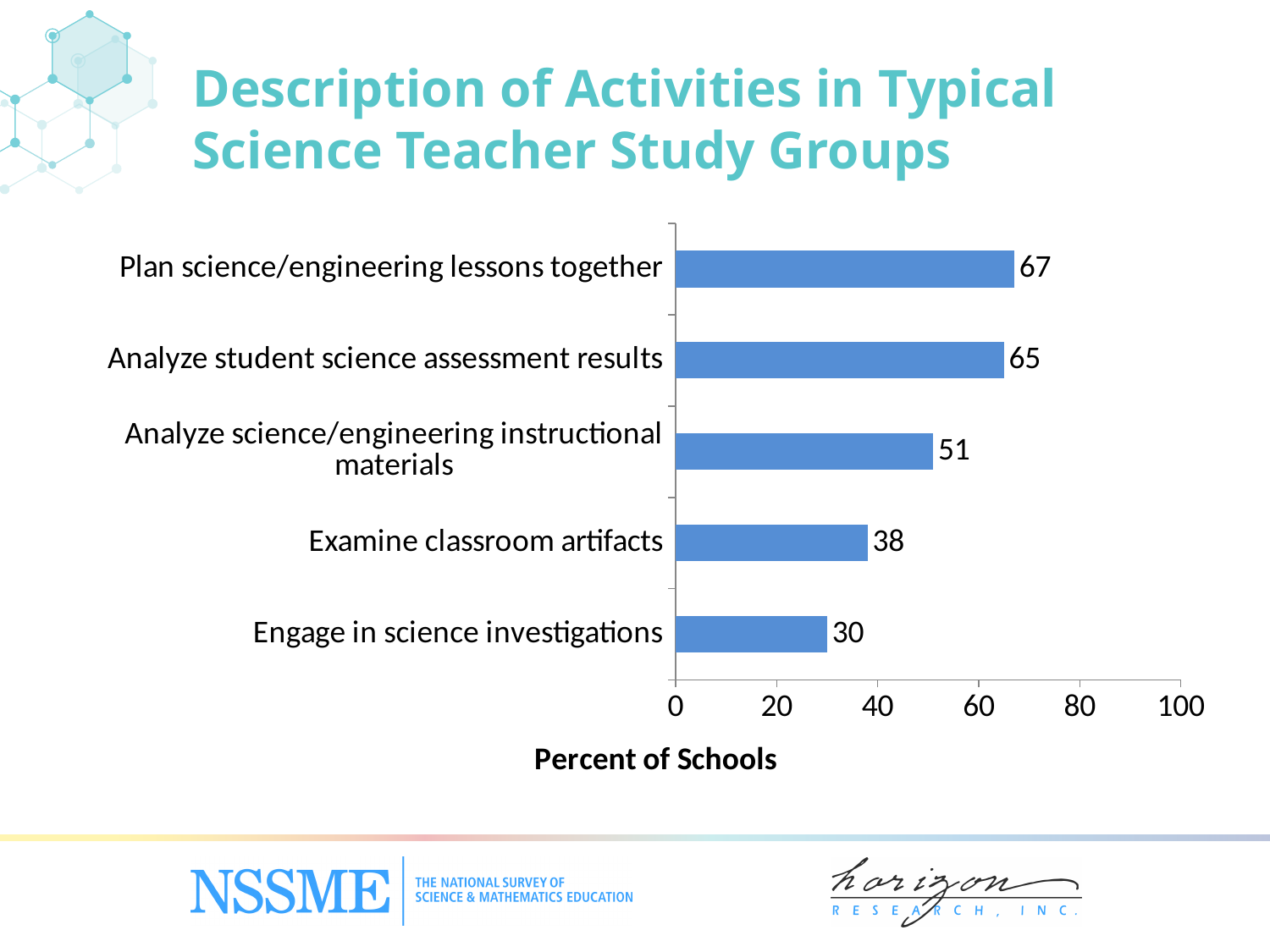
Which activity has the lowest percent of schools? Engage in science investigations How many activities are shown in the chart? 5 What is the difference between the values for 'Analyze student science assessment results' and 'Examine classroom artifacts'? 27 What is the label of the horizontal axis? Percent of Schools Is the value for 'Analyze student science assessment results' greater or less than 60? greater What percent of schools report that study groups plan science/engineering lessons together? 67 What is the value for 'Analyze science/engineering instructional materials'? 51 What is the title of the slide? Description of Activities in Typical Science Teacher Study Groups Which activity has the highest percent of schools? Plan science/engineering lessons together What is the value for 'Engage in science investigations'? 30 What kind of chart is shown on the slide? Bar chart Which is larger: the value for 'Examine classroom artifacts' or 'Engage in science investigations'? Examine classroom artifacts